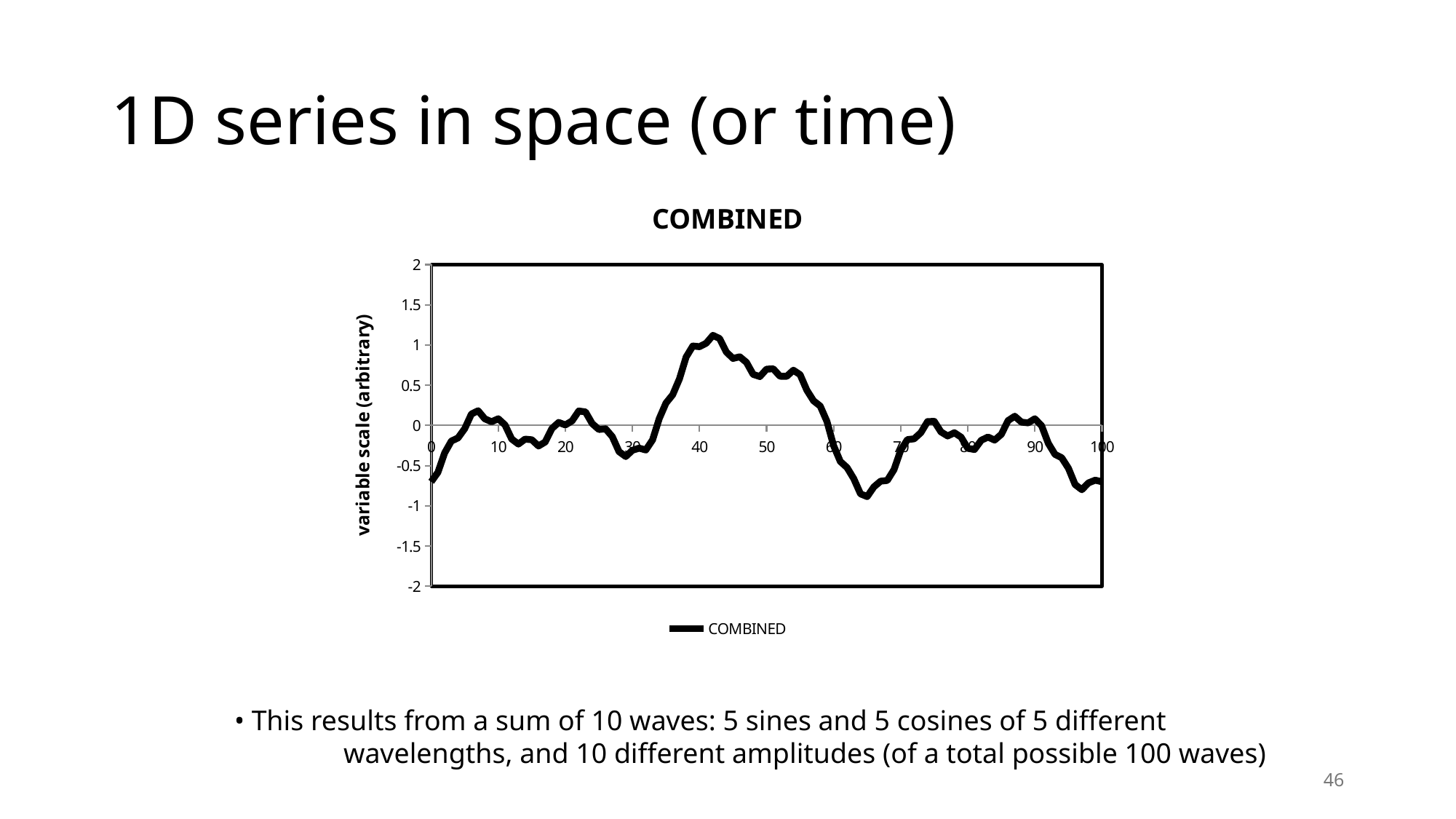
What is the highest tick value shown on the vertical axis? 2 Is the value of the COMBINED series at x = 40 greater or less than 0.5? greater What kind of chart is shown on the slide? line chart Is the value of the COMBINED series at x = 0 greater or less than 0? less What is the title of the chart? COMBINED What is the label on the vertical axis of the chart? variable scale (arbitrary) Which is larger, the value of the COMBINED series at x = 40 or at x = 65? x = 40 Is the value of the COMBINED series at x = 50 greater or less than 0? greater How many series does the legend list? 1 Does the COMBINED series rise or fall between x = 30 and x = 40? rise Does the COMBINED series rise or fall between x = 55 and x = 65? fall